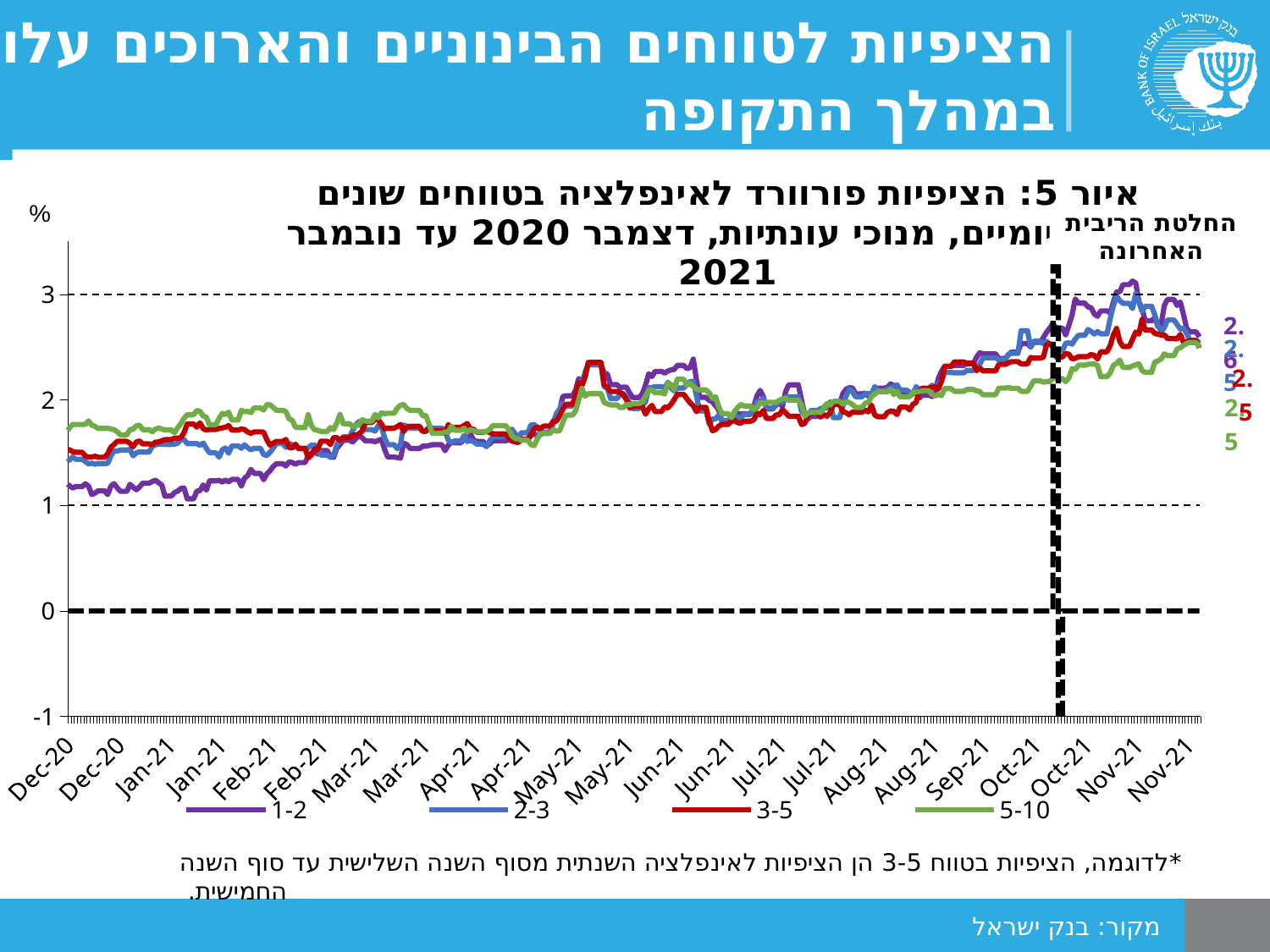
What are the four series listed in the legend? 1-2, 2-3, 3-5, 5-10 How many series does the legend list? 4 Does the 1-2 series generally rise or fall from Dec-20 to Nov-21? rise Is the value of the 5-10 series in Nov-21 greater or less than 2? greater Which series has the lowest value at the start of the period (Dec-20)? 1-2 At the start of the period (Dec-20), which is larger: the 1-2 series or the 5-10 series? 5-10 What unit is shown on the y axis? % Is the value of the 1-2 series in Dec-20 greater or less than 2? less What kind of chart is shown on the slide? line chart Which series has the highest value at the start of the period (Dec-20)? 5-10 Which series reaches the highest value anywhere on the chart? 1-2 Is the peak value of the 1-2 series in Nov-21 greater or less than 3? greater